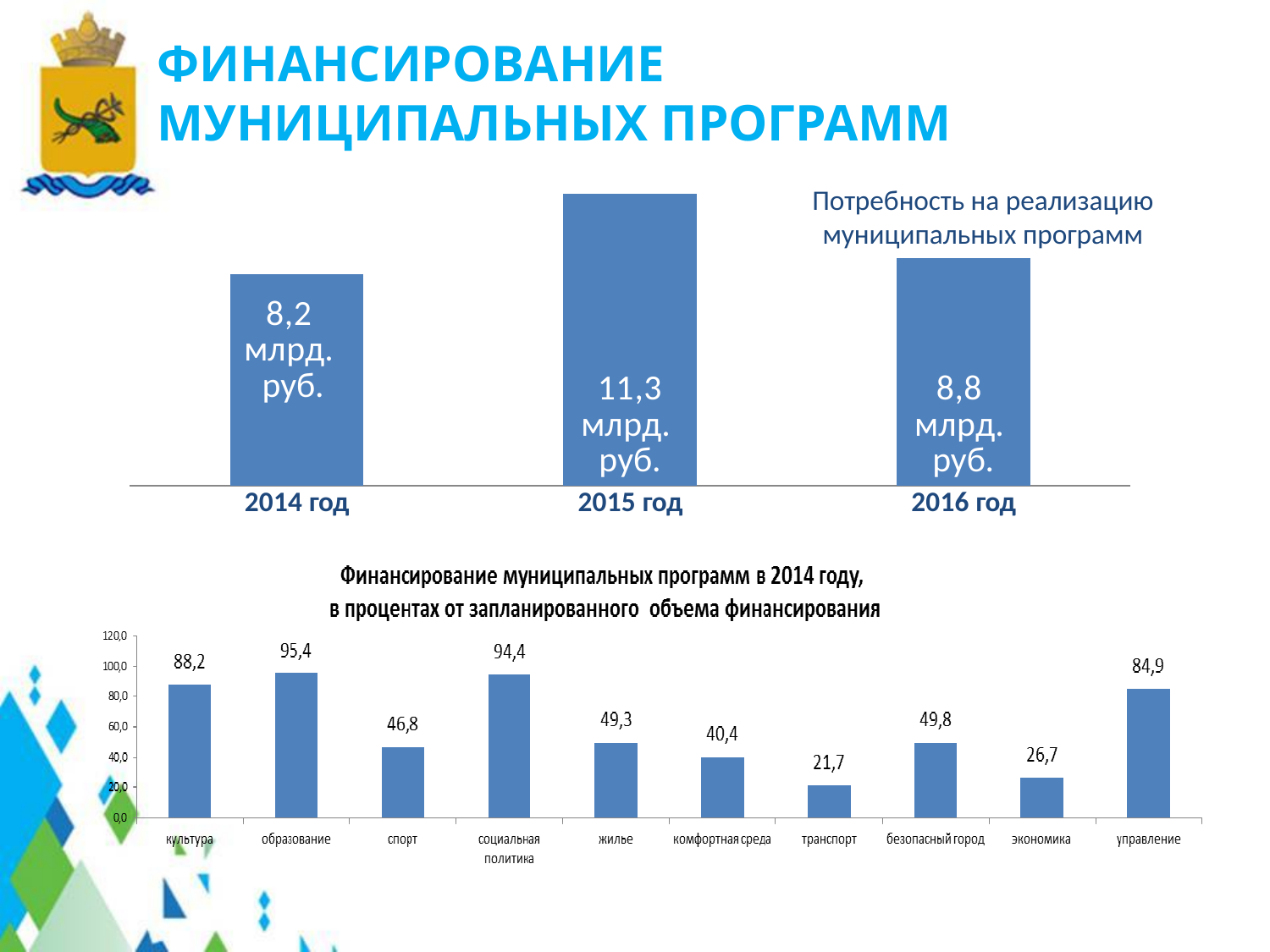
In the bottom chart (Финансирование муниципальных программ в 2014 году), how many categories are shown? 10 In the bottom chart (Финансирование муниципальных программ в 2014 году), what is the value for транспорт? 21,7 In the top chart (Потребность на реализацию муниципальных программ), what is the value for 2015 год? 11,3 млрд. руб. In the top chart (Потребность на реализацию муниципальных программ), what is the difference between the values for 2015 год and 2014 год? 3,1 млрд. руб. In the top chart (Потребность на реализацию муниципальных программ), which year has the lowest value? 2014 год What kind of chart is the bottom chart (Финансирование муниципальных программ в 2014 году)? bar chart In the bottom chart (Финансирование муниципальных программ в 2014 году), what is the value for образование? 95,4 In the top chart (Потребность на реализацию муниципальных программ), how many years are shown? 3 In the bottom chart (Финансирование муниципальных программ в 2014 году), which category has the lowest value? транспорт In the bottom chart (Финансирование муниципальных программ в 2014 году), which category has the highest value? образование In the bottom chart (Финансирование муниципальных программ в 2014 году), which is larger: the value for культура or the value for управление? культура In the top chart (Потребность на реализацию муниципальных программ), which year has the highest value? 2015 год